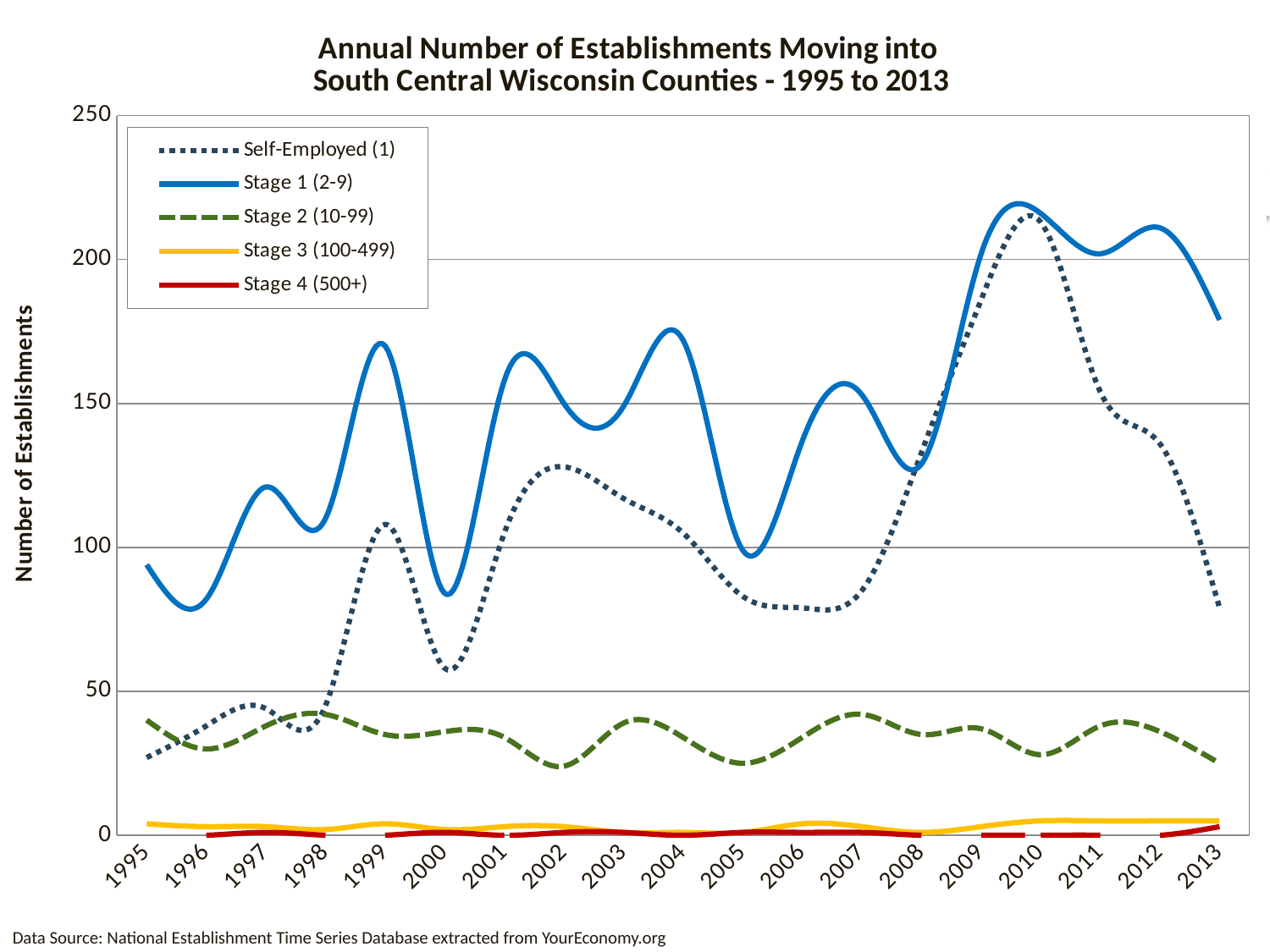
Is the value for Stage 1 (2-9) in 2000 greater or less than 100? less What kind of chart is shown on the slide? line chart In 2005, which is larger: Stage 2 (10-99) or Stage 3 (100-499)? Stage 2 (10-99) Is the value for Stage 1 (2-9) in 2010 greater or less than 200? greater Is the value for Self-Employed (1) in 2013 greater or less than 100? less In 2013, which is larger: Stage 1 (2-9) or Self-Employed (1)? Stage 1 (2-9) How many years are plotted along the x axis? 19 Does the Self-Employed (1) series rise or fall from 2010 to 2013? fall What is the label on the y axis of the chart? Number of Establishments How many series does the legend list? 5 In which year does the Self-Employed (1) series reach its highest value? 2010